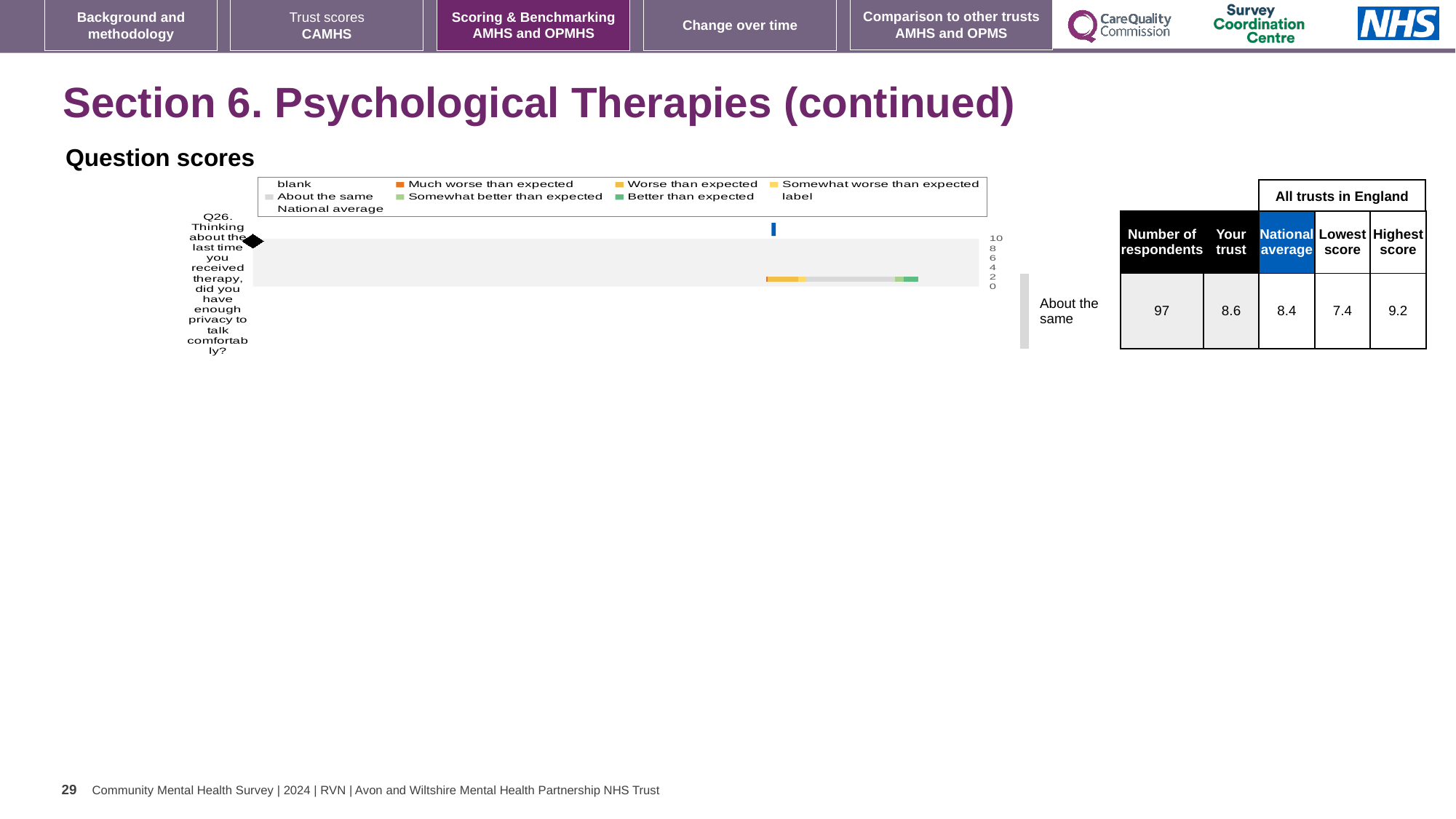
Which question number is plotted in the Question scores chart? Q26 For Q26, what is the difference between the Highest score and the Lowest score among all trusts in England? 1.8 In the table beside the chart, what is the 'Your trust' score for Q26? 8.6 What kind of chart is shown under 'Question scores'? bar chart How many entries does the legend of the Question scores chart list? 9 In the table beside the chart, what is the Highest score among all trusts in England for Q26? 9.2 In the table beside the chart, how many respondents are recorded for Q26? 97 How many questions (categories) are plotted in the Question scores chart? 1 What benchmark category is shown next to the Q26 chart? About the same In the table beside the chart, what is the Lowest score among all trusts in England for Q26? 7.4 For Q26, which is larger: the 'Your trust' score or the National average? Your trust In the table beside the chart, what is the National average score for Q26? 8.4